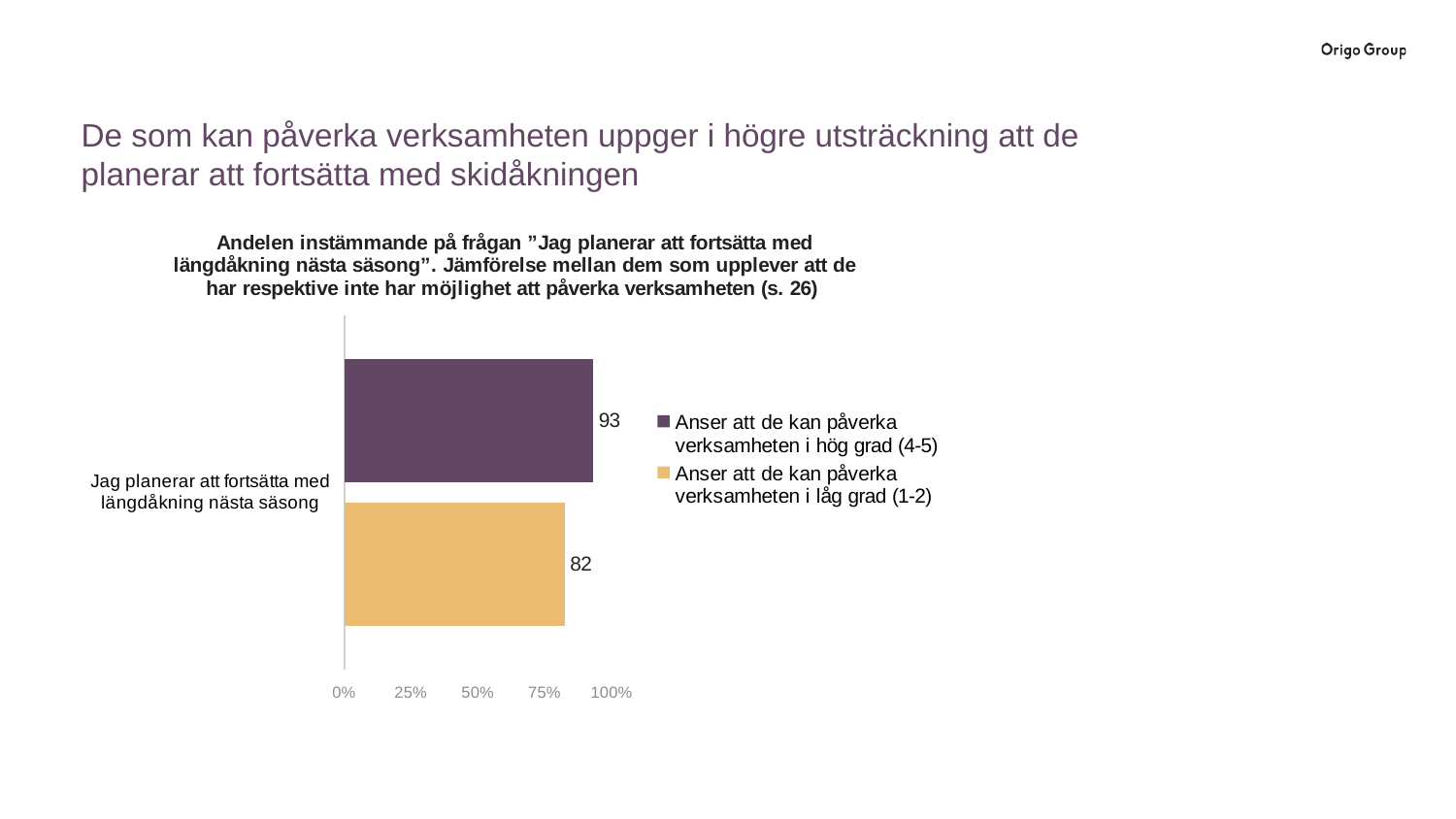
What is the category label shown on the chart? Jag planerar att fortsätta med längdåkning nästa säsong Is the value for the high-influence (4-5) group larger or smaller than the value for the low-influence (1-2) group? larger What is the difference between the values for the high-influence (4-5) group and the low-influence (1-2) group? 11 How many categories are shown on the category axis? 1 What kind of chart is shown on the slide? bar chart Which series has the higher value? Anser att de kan påverka verksamheten i hög grad (4-5) How many series does the legend list? 2 What value is shown for the series "Anser att de kan påverka verksamheten i hög grad (4-5)"? 93 What colour is the bar for the series "Anser att de kan påverka verksamheten i låg grad (1-2)"? yellow/orange What value is shown for the series "Anser att de kan påverka verksamheten i låg grad (1-2)"? 82 Which series has the lower value? Anser att de kan påverka verksamheten i låg grad (1-2) Is the value for the low-influence (1-2) group greater or less than 75%? greater